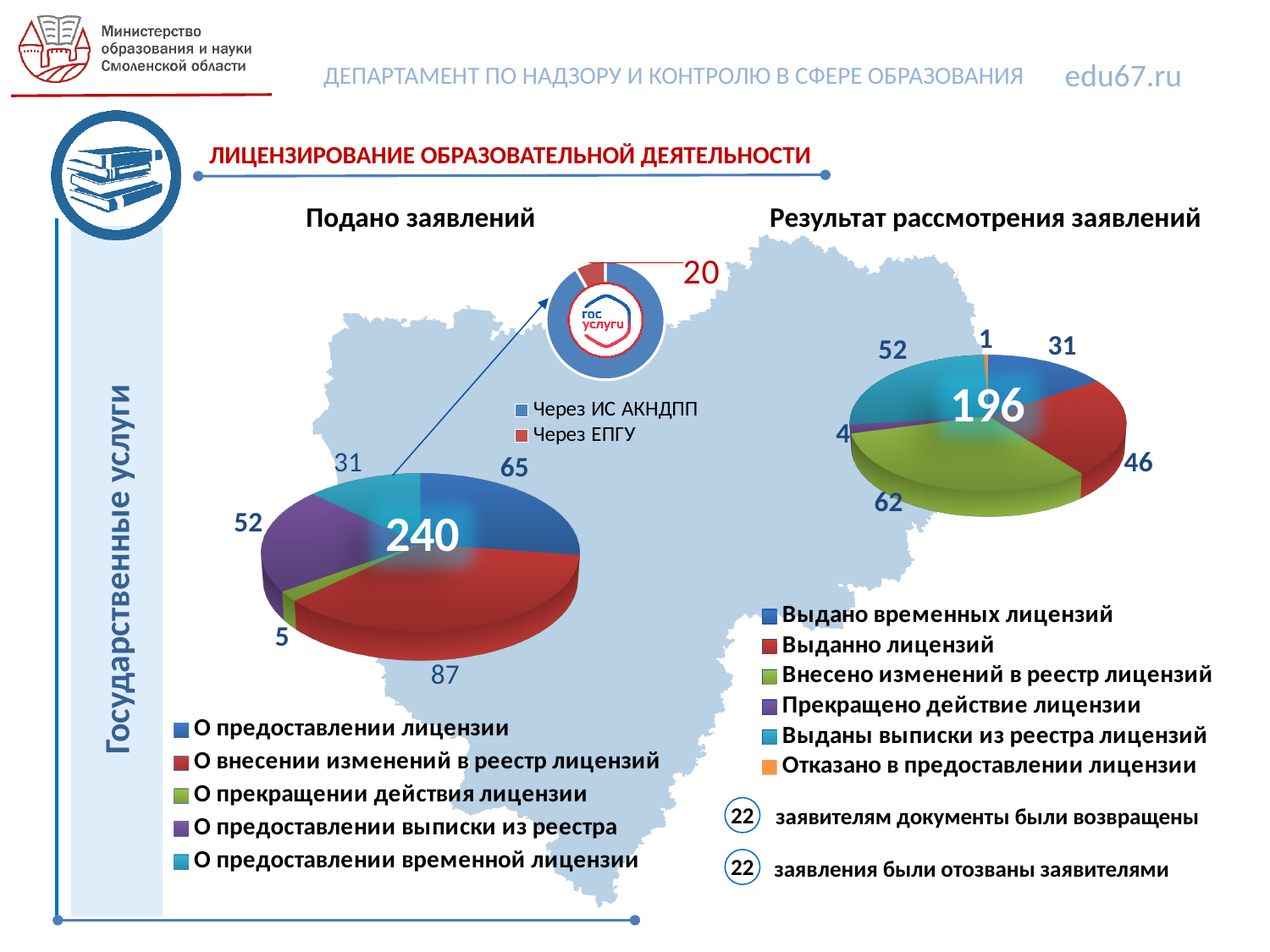
In the 'Подано заявлений' pie chart, what is the value for 'О внесении изменений в реестр лицензий'? 87 What type of chart is used for 'Подано заявлений'? Pie chart In the 'Результат рассмотрения заявлений' pie chart, what is the value for 'Внесено изменений в реестр лицензий'? 62 In the 'Результат рассмотрения заявлений' pie chart, what is the difference between 'Выданы выписки из реестра лицензий' and 'Прекращено действие лицензии'? 48 In the 'Подано заявлений' pie chart, what is the total number shown in the centre of the pie? 240 In the 'Подано заявлений' pie chart, which category has the smallest value? О прекращении действия лицензии How many categories does the legend of the 'Результат рассмотрения заявлений' pie chart list? 6 In the 'Результат рассмотрения заявлений' pie chart, which is larger: 'Выдано временных лицензий' or 'Выданно лицензий'? Выданно лицензий In the 'Результат рассмотрения заявлений' pie chart, which category has the smallest value? Отказано в предоставлении лицензии In the small pie chart at the top of the slide, what value is labelled for 'Через ЕПГУ'? 20 In the 'Подано заявлений' pie chart, what is the difference between 'О предоставлении лицензии' and 'О предоставлении временной лицензии'? 34 In the 'Подано заявлений' pie chart, which category has the largest value? О внесении изменений в реестр лицензий